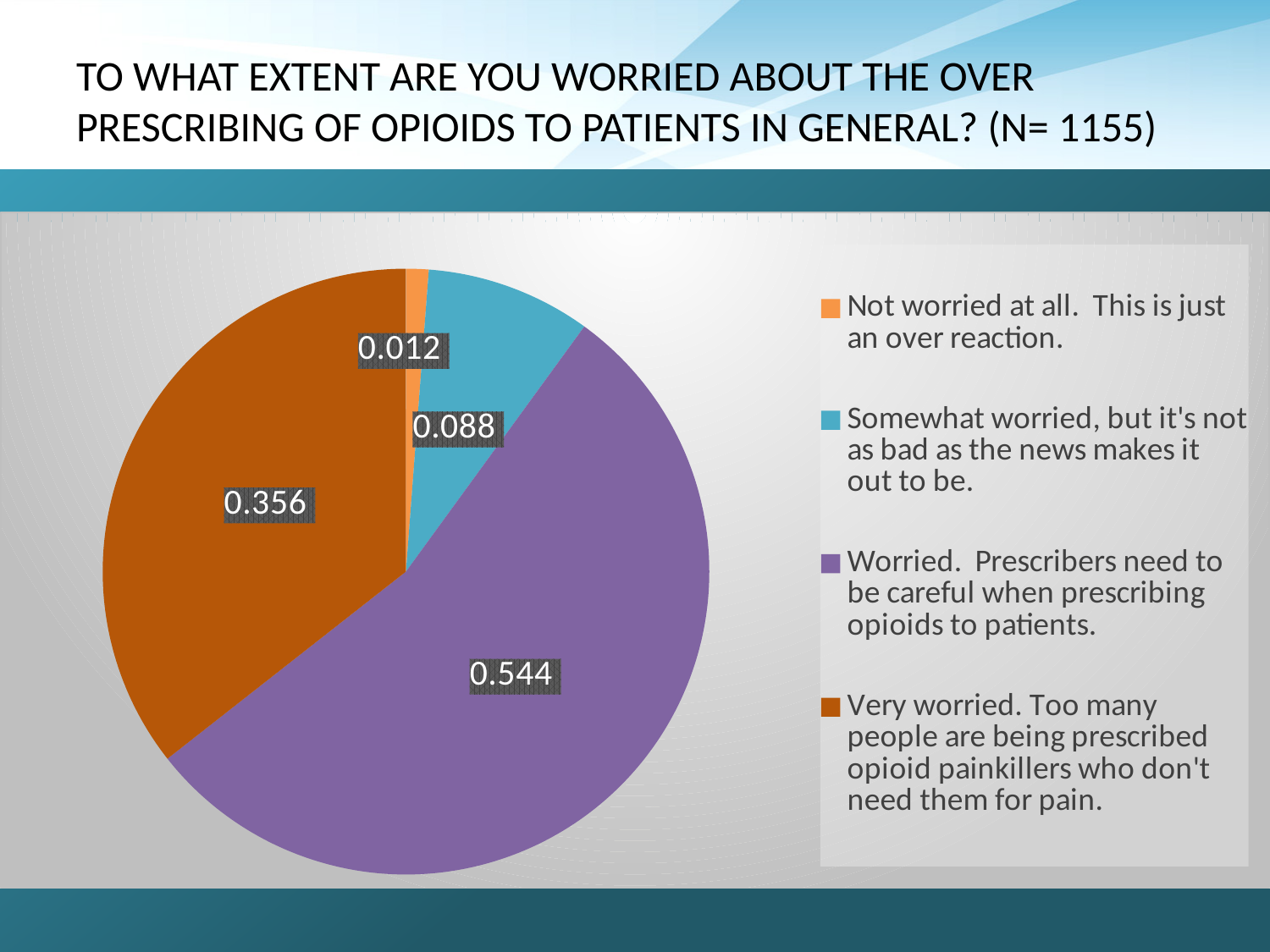
What sample size (N) is given in the chart title? 1155 Which response category has the smallest slice of the pie? Not worried at all. This is just an over reaction. How many categories does the pie chart show? 4 What value is shown for the "Somewhat worried, but it's not as bad as the news makes it out to be." slice? 0.088 What value is shown for the "Not worried at all. This is just an over reaction." slice? 0.012 What kind of chart is shown on the slide? Pie chart What value is shown for the "Very worried" slice? 0.356 What is the difference between the "Worried" value and the "Very worried" value? 0.188 Which is larger, the "Somewhat worried" slice or the "Not worried at all" slice? Somewhat worried, but it's not as bad as the news makes it out to be. Which response category has the largest slice of the pie? Worried. Prescribers need to be careful when prescribing opioids to patients. What value is shown for the "Worried. Prescribers need to be careful when prescribing opioids to patients." slice? 0.544 What colour is the slice for "Very worried. Too many people are being prescribed opioid painkillers who don't need them for pain."? Orange (brown)